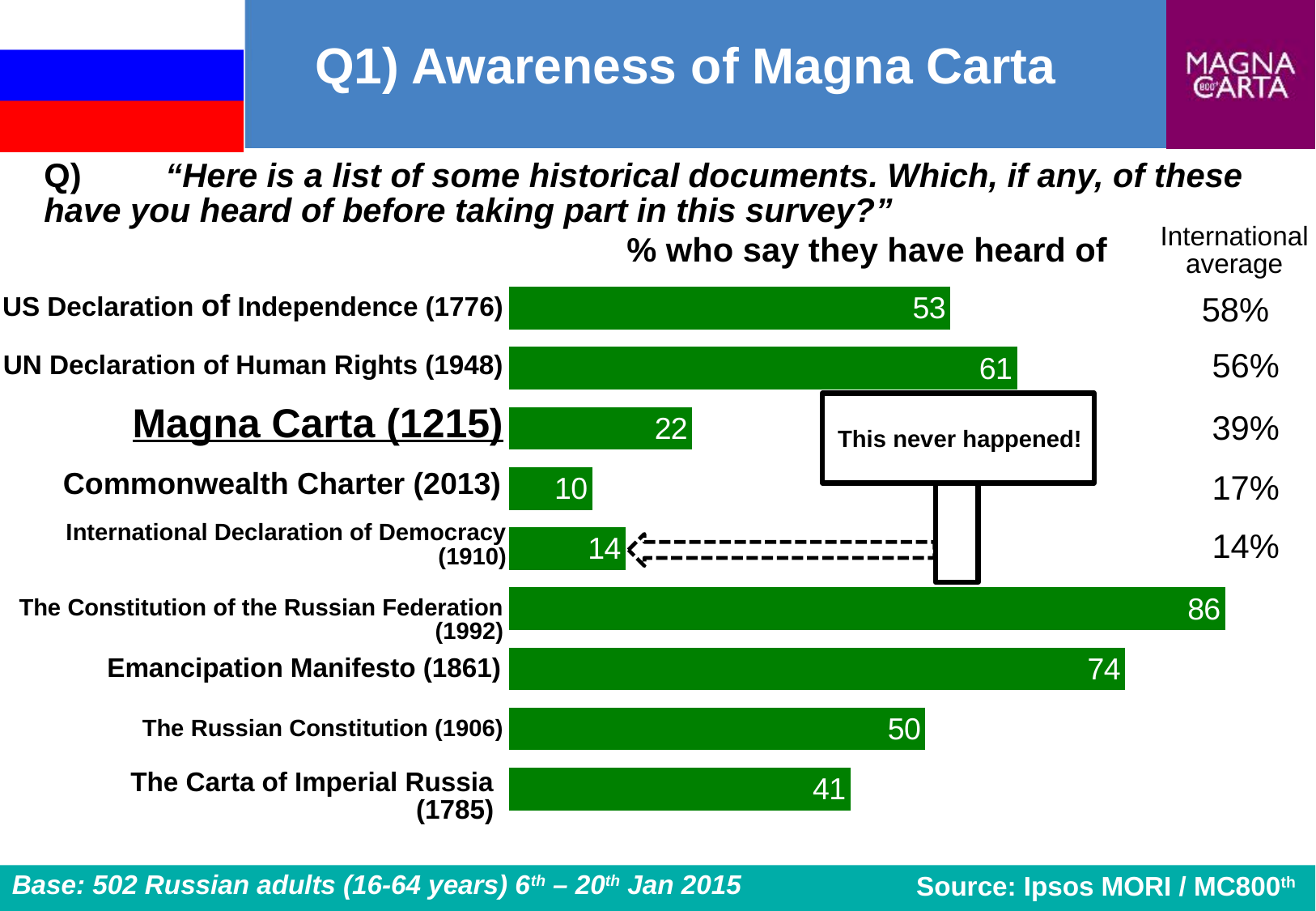
Which document has the highest percentage of people who say they have heard of it? The Constitution of the Russian Federation (1992) Which has a higher percentage: The Russian Constitution (1906) or The Carta of Imperial Russia (1785)? The Russian Constitution (1906) What type of chart is used on this slide? Bar chart What is the international average shown for Magna Carta (1215)? 39% Which document has the lowest percentage of people who say they have heard of it? Commonwealth Charter (2013) How many historical documents are shown as bars in the chart? 9 What percentage say they have heard of the Commonwealth Charter (2013)? 10 What percentage of Russian adults say they have heard of Magna Carta (1215)? 22 What percentage say they have heard of the Emancipation Manifesto (1861)? 74 What is the difference between the percentage who have heard of the UN Declaration of Human Rights (1948) and the US Declaration of Independence (1776)? 8 What is the difference between the percentage who have heard of the Constitution of the Russian Federation (1992) and the International Declaration of Democracy (1910)? 72 What does the callout box pointing to the International Declaration of Democracy (1910) bar say? This never happened!